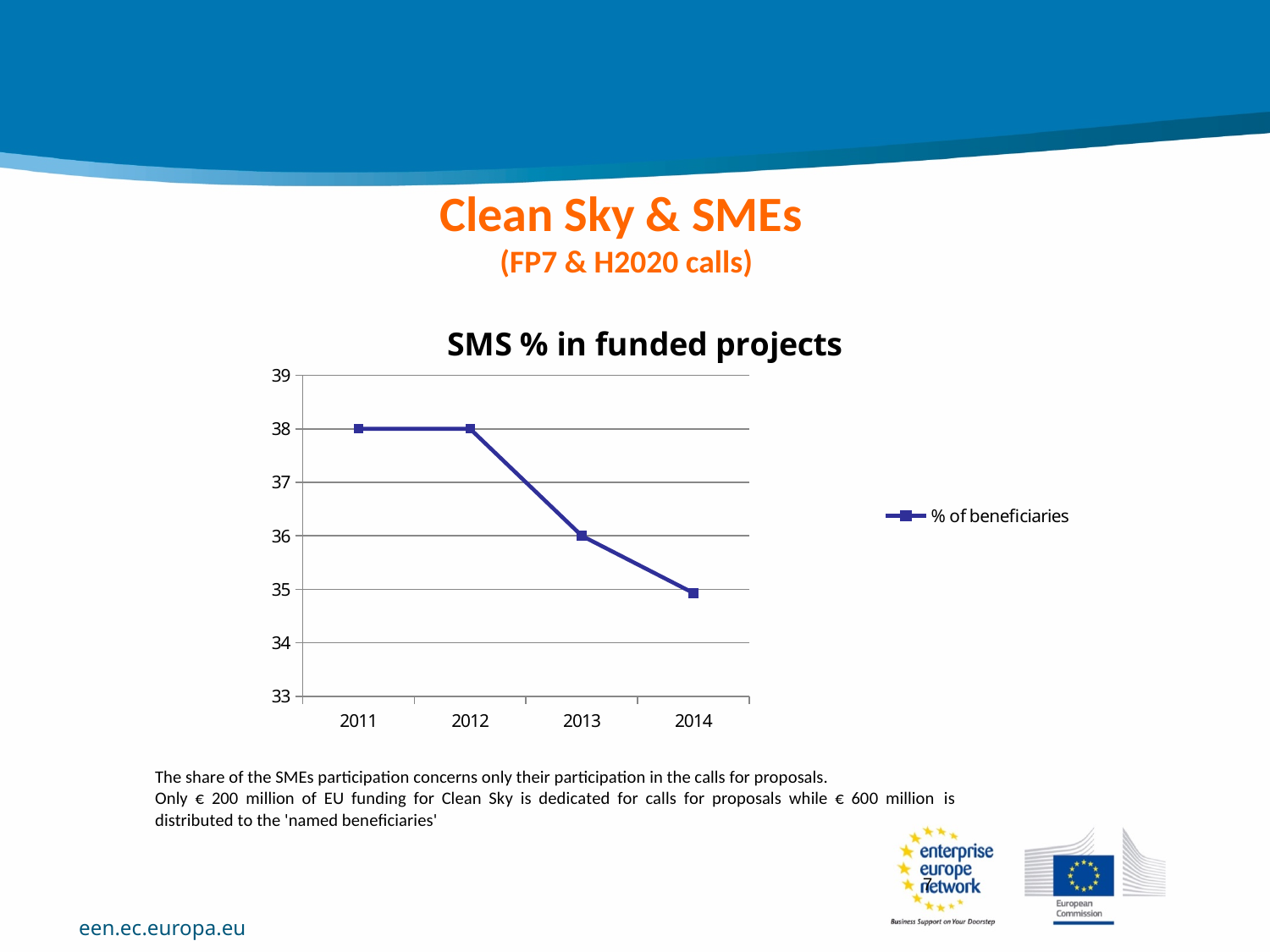
What is the title of the chart? SMS % in funded projects What is the value for 2011? 38 What is the difference between the values for 2011 and 2013? 2 Is the value for 2014 greater or less than 36? less What is the value for 2012? 38 What series name does the chart legend list? % of beneficiaries What type of chart is shown on the slide? Line chart What is the value for 2013? 36 Which year has the lowest value? 2014 Do the values rise or fall from 2011 to 2014? Fall How many series does the legend list? 1 How many years are plotted on the x axis? 4